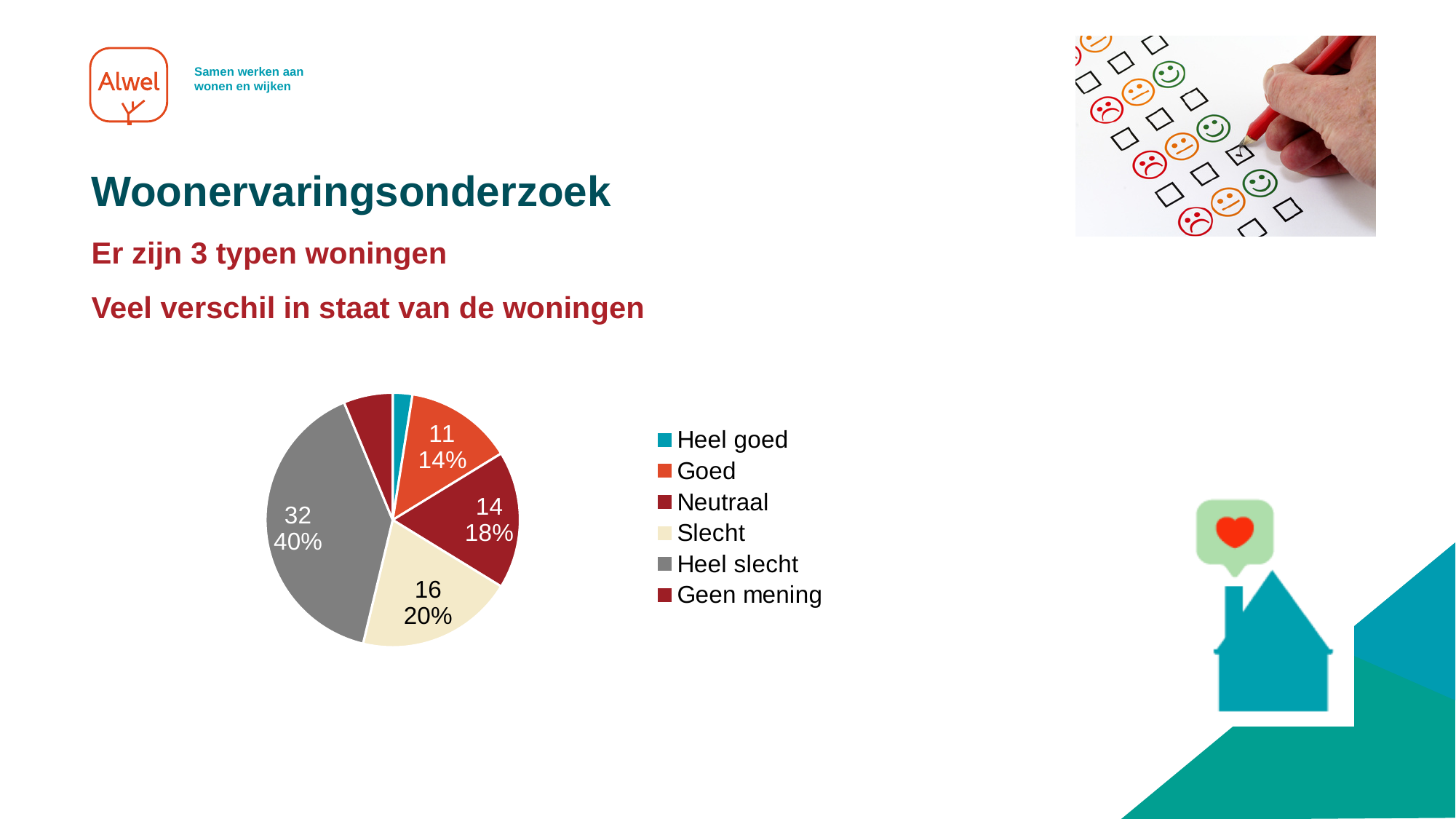
What count is shown for the Heel slecht slice? 32 What count is shown for the Goed slice of the pie chart? 11 What percentage is shown for the Neutraal slice? 18% How many categories does the legend of the pie chart list? 6 What kind of chart is shown on the slide? Pie chart Which category has the smallest slice of the pie chart? Heel goed What share of the pie does Heel slecht represent? 40% Which category has the largest slice of the pie chart? Heel slecht Which is larger, the count for Goed or the count for Neutraal? Neutraal Which legend entry is shown in grey? Heel slecht What count is shown for the Slecht slice? 16 What is the difference between the counts for Heel slecht and Slecht? 16